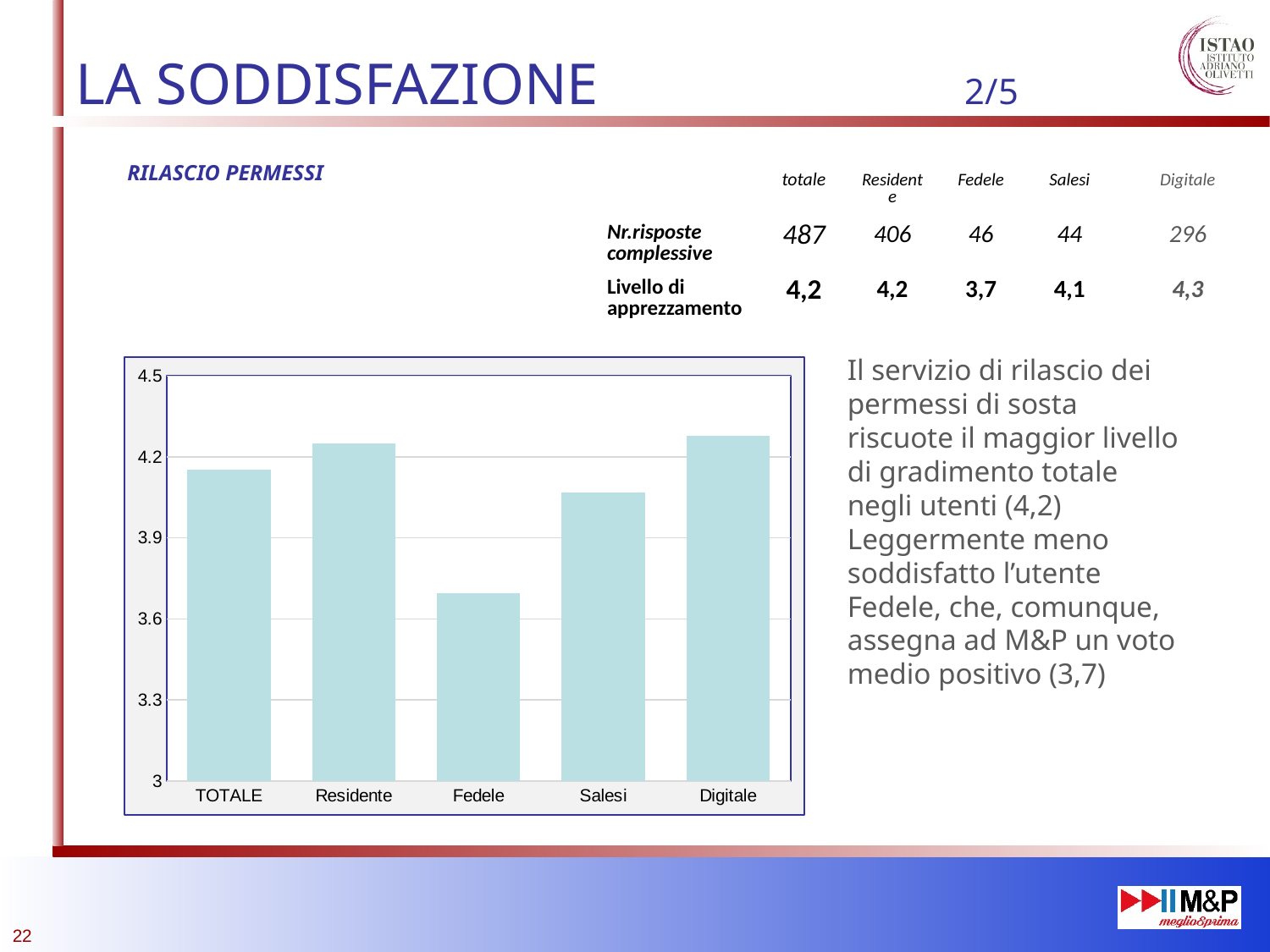
Which is larger, the bar for Residente or the bar for TOTALE? Residente What kind of chart is shown on the slide? bar chart Is the value for Fedele greater or less than 3.9? less Which is larger, the bar for Residente or the bar for Salesi? Residente How many categories are shown on the x axis of the chart? 5 What is the lowest value shown on the chart's y axis? 3 Which is larger, the bar for Salesi or the bar for Fedele? Salesi Is the value for TOTALE greater or less than 3.9? greater Is the value for Salesi greater or less than 4.2? less Which category has the lowest bar in the chart? Fedele